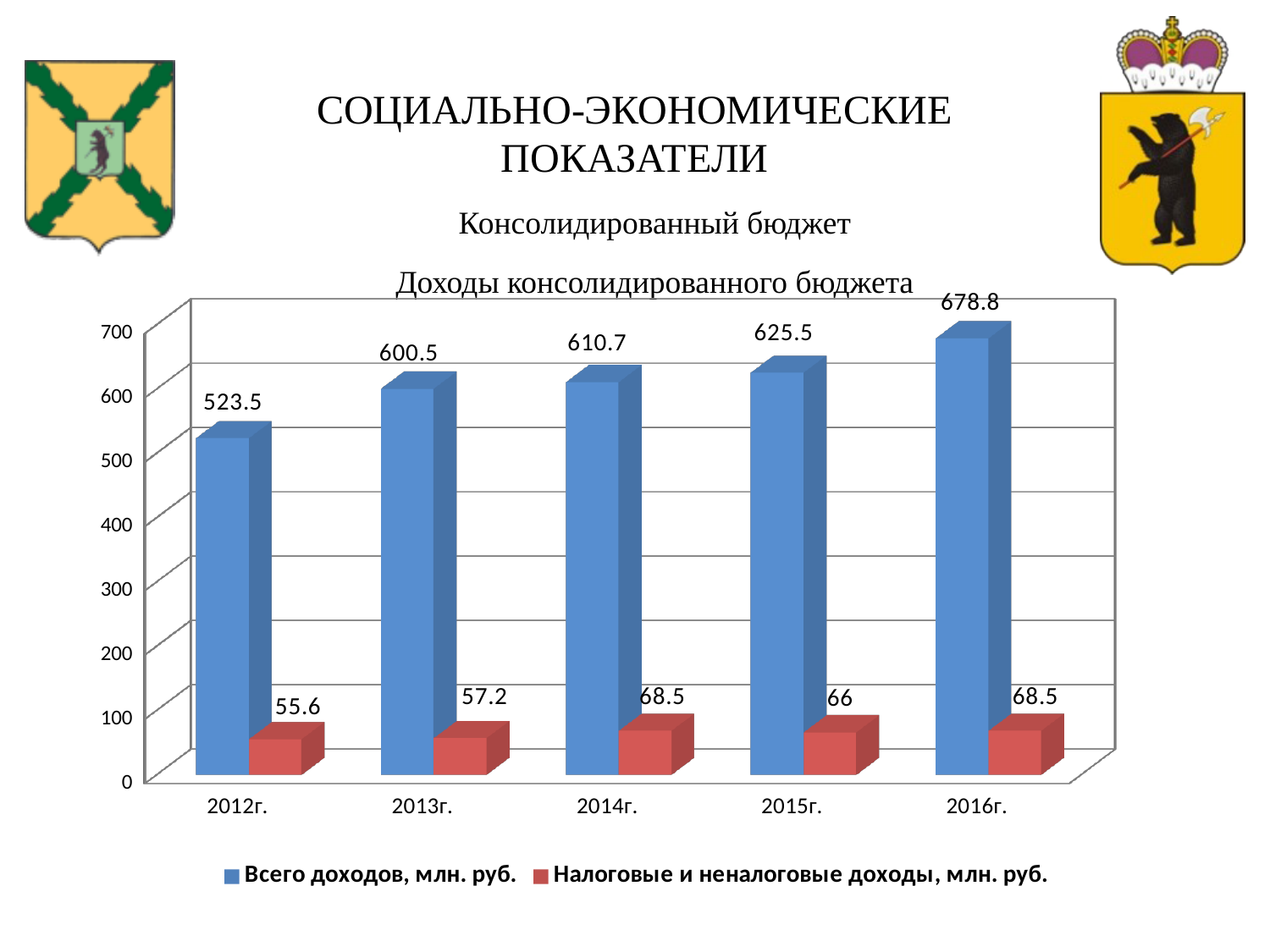
How many years are shown on the x axis of the chart? 5 Does 'Всего доходов, млн. руб.' rise or fall from 2012г. to 2016г.? rise Is the value for 'Всего доходов, млн. руб.' in 2012г. greater or less than 500? greater What is the value of 'Всего доходов, млн. руб.' for 2014г.? 610.7 How many series does the legend list? 2 What is the value of 'Всего доходов, млн. руб.' for 2016г.? 678.8 What is the difference between 'Всего доходов, млн. руб.' in 2016г. and in 2015г.? 53.3 Which is larger: 'Налоговые и неналоговые доходы, млн. руб.' in 2013г. or in 2015г.? 2015г. What kind of chart is shown on the slide? bar chart Which year has the highest value for 'Всего доходов, млн. руб.'? 2016г. What is the value of 'Налоговые и неналоговые доходы, млн. руб.' for 2012г.? 55.6 Which year has the lowest value for 'Налоговые и неналоговые доходы, млн. руб.'? 2012г.